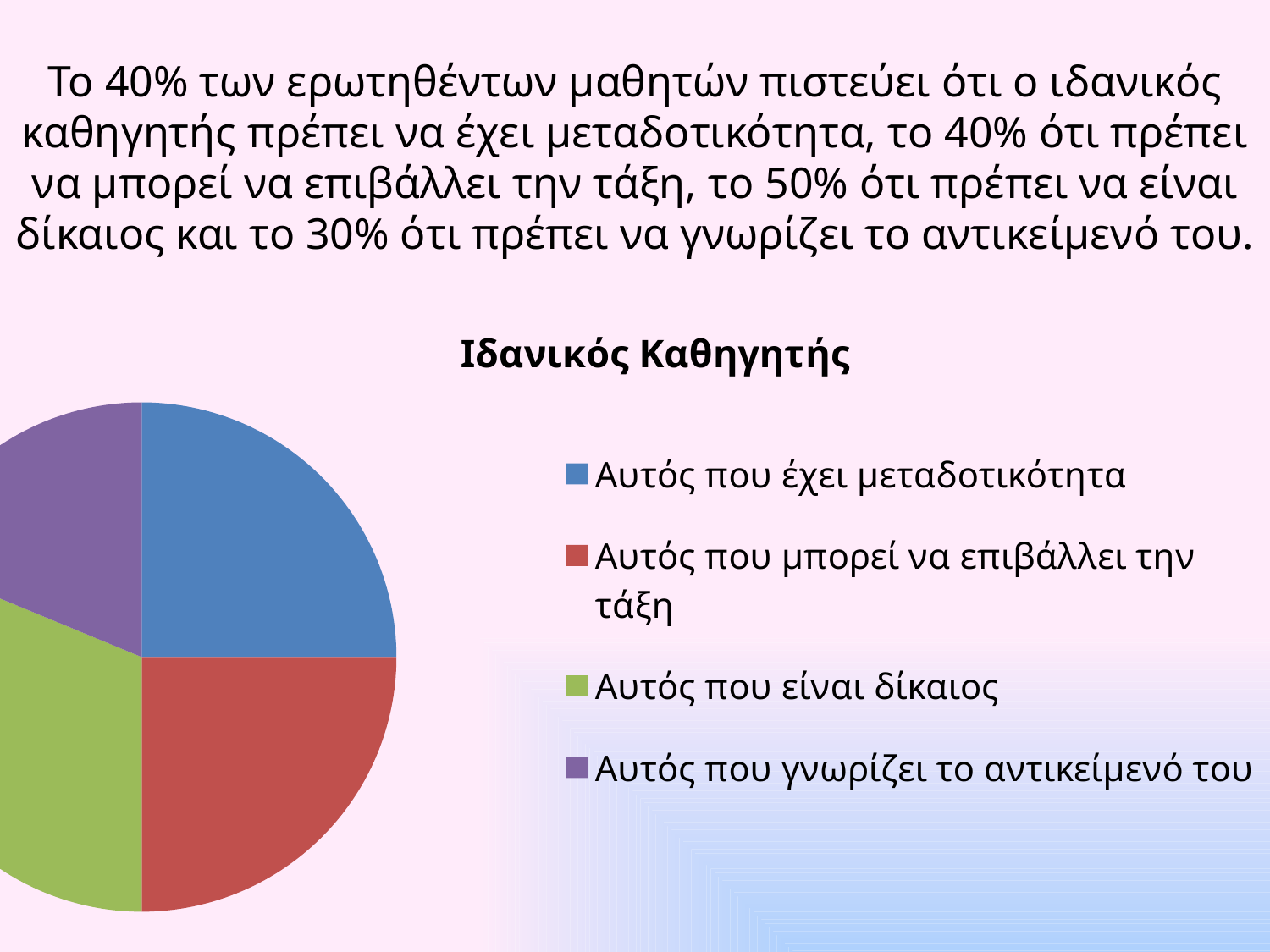
According to the slide, what percentage of students said the ideal teacher should be fair ('δίκαιος')? 50% Which slice is larger: 'Αυτός που είναι δίκαιος' or 'Αυτός που γνωρίζει το αντικείμενό του'? Αυτός που είναι δίκαιος Which legend entry is shown in green? Αυτός που είναι δίκαιος Which slice of the pie is the smallest? Αυτός που γνωρίζει το αντικείμενό του According to the slide, what percentage of students said the ideal teacher should have 'μεταδοτικότητα'? 40% Which slice is larger: 'Αυτός που έχει μεταδοτικότητα' or 'Αυτός που γνωρίζει το αντικείμενό του'? Αυτός που έχει μεταδοτικότητα How many entries does the legend list? 4 According to the slide, what percentage of students said the ideal teacher should know his subject ('γνωρίζει το αντικείμενό του')? 30% What is the title of the chart? Ιδανικός Καθηγητής Which slice of the pie is the largest? Αυτός που είναι δίκαιος What kind of chart is shown on the slide? pie chart How many slices does the pie chart have? 4